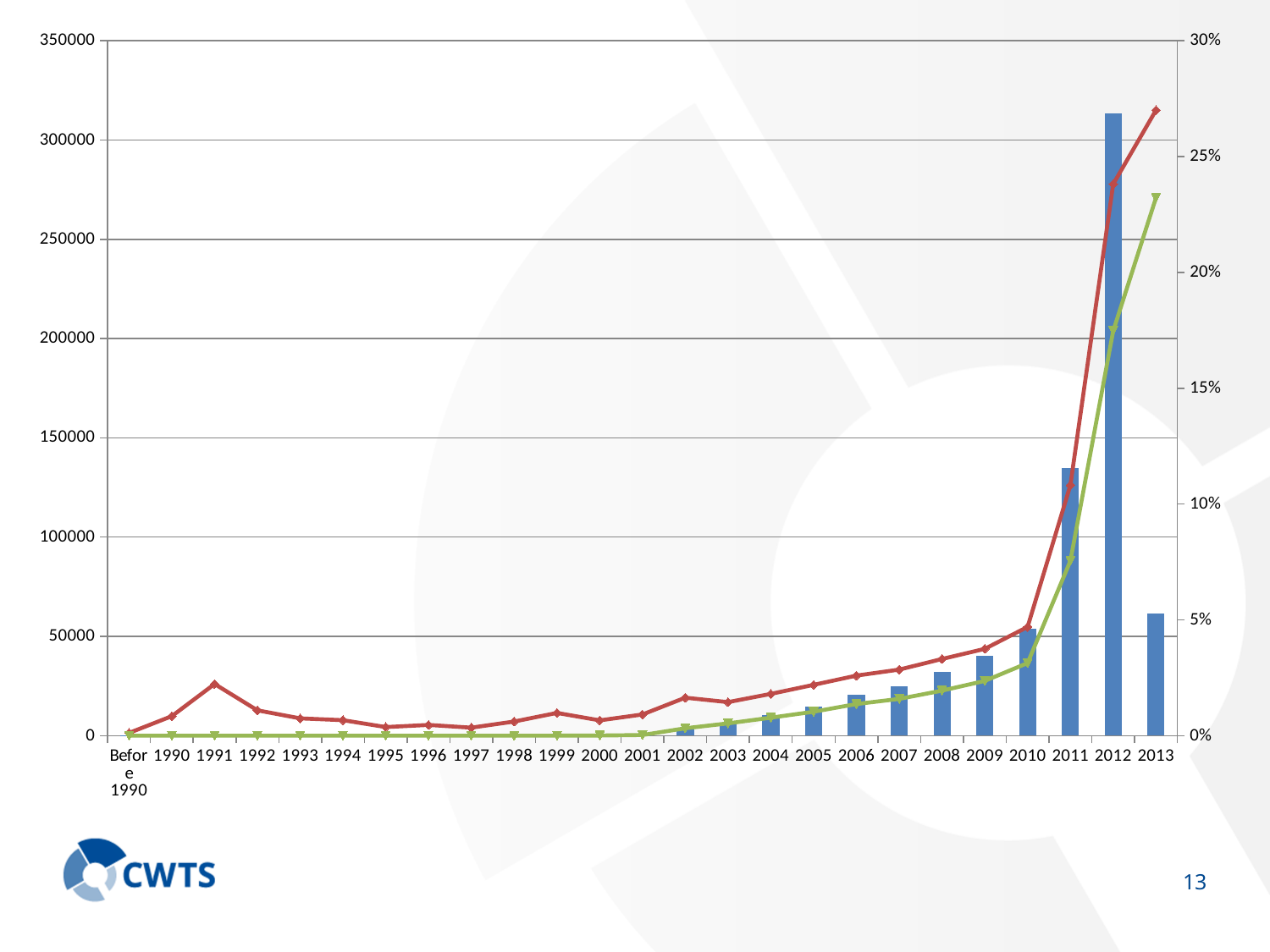
Is the red line value for 2013 greater or less than 25%? greater Is the bar for 2011 greater or less than 100000? greater What kind of chart is shown on the slide? A combination bar and line chart Is the bar for 2012 greater or less than 300000? greater What is the highest value shown on the right-hand axis? 30% How many categories are shown on the x axis? 25 Which year has the tallest bar? 2012 Do the bars rise or fall from 2009 to 2012? Rise Which bar is taller, 2011 or 2013? 2011 At 2012, which line is higher, the red line or the green line? The red line